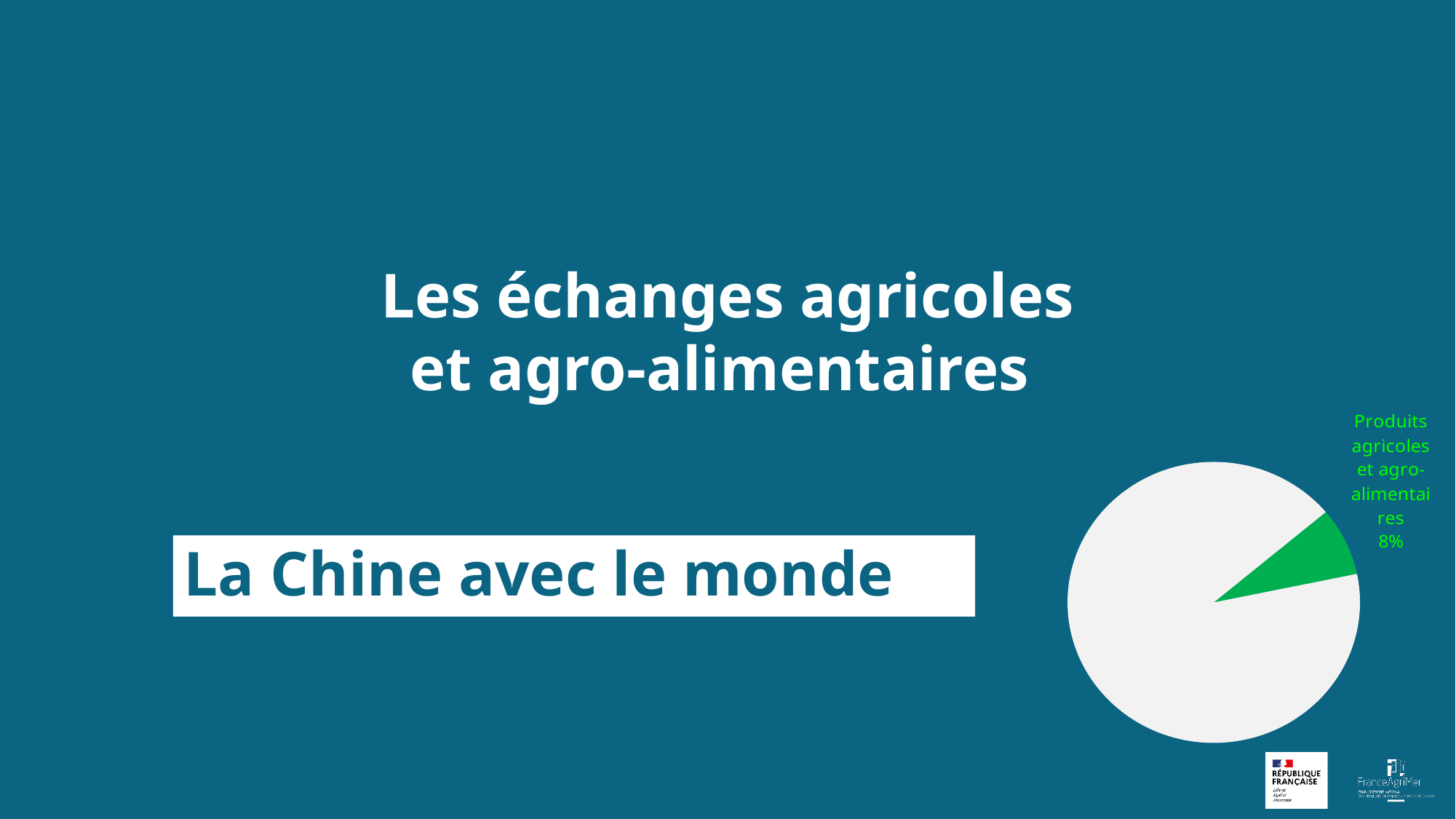
What is the value printed for the "Produits agricoles et agro-alimentaires" slice of the pie chart? 8% How many slices does the pie chart have? 2 What kind of chart is shown on the slide? pie chart Is the share of the "Produits agricoles et agro-alimentaires" slice greater or less than 10%? less Which slice of the pie chart is the smallest? Produits agricoles et agro-alimentaires What colour is the slice labelled "Produits agricoles et agro-alimentaires" in the pie chart? green What share of the pie does the slice labelled "Produits agricoles et agro-alimentaires" represent? 8% Which slice of the pie chart is larger, the green slice or the grey slice? the grey slice